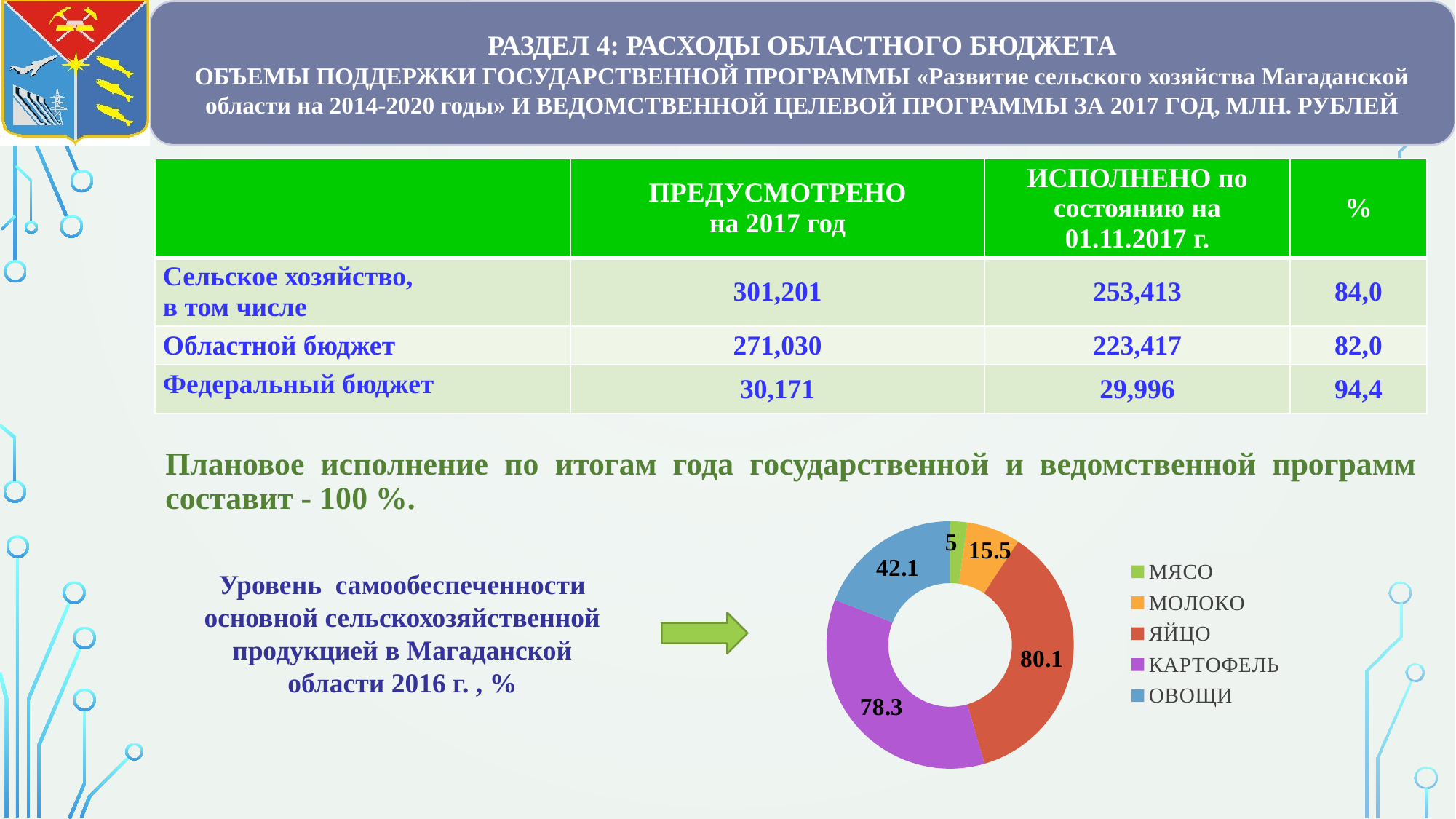
What is the difference between the values for ОВОЩИ and МОЛОКО in the doughnut chart? 26.6 Which colour represents КАРТОФЕЛЬ in the doughnut chart? Purple How many categories does the legend of the doughnut chart list? 5 In the doughnut chart, what is the value for ЯЙЦО? 80.1 In the doughnut chart, what is the value for КАРТОФЕЛЬ? 78.3 What is the difference between the values for ЯЙЦО and КАРТОФЕЛЬ in the doughnut chart? 1.8 In the doughnut chart, what is the value for МОЛОКО? 15.5 Which category has the highest value in the doughnut chart? ЯЙЦО Which category has the lowest value in the doughnut chart? МЯСО In the doughnut chart, what is the value for МЯСО? 5 In the doughnut chart, what is the value for ОВОЩИ? 42.1 What kind of chart is shown on the slide? Doughnut (pie) chart